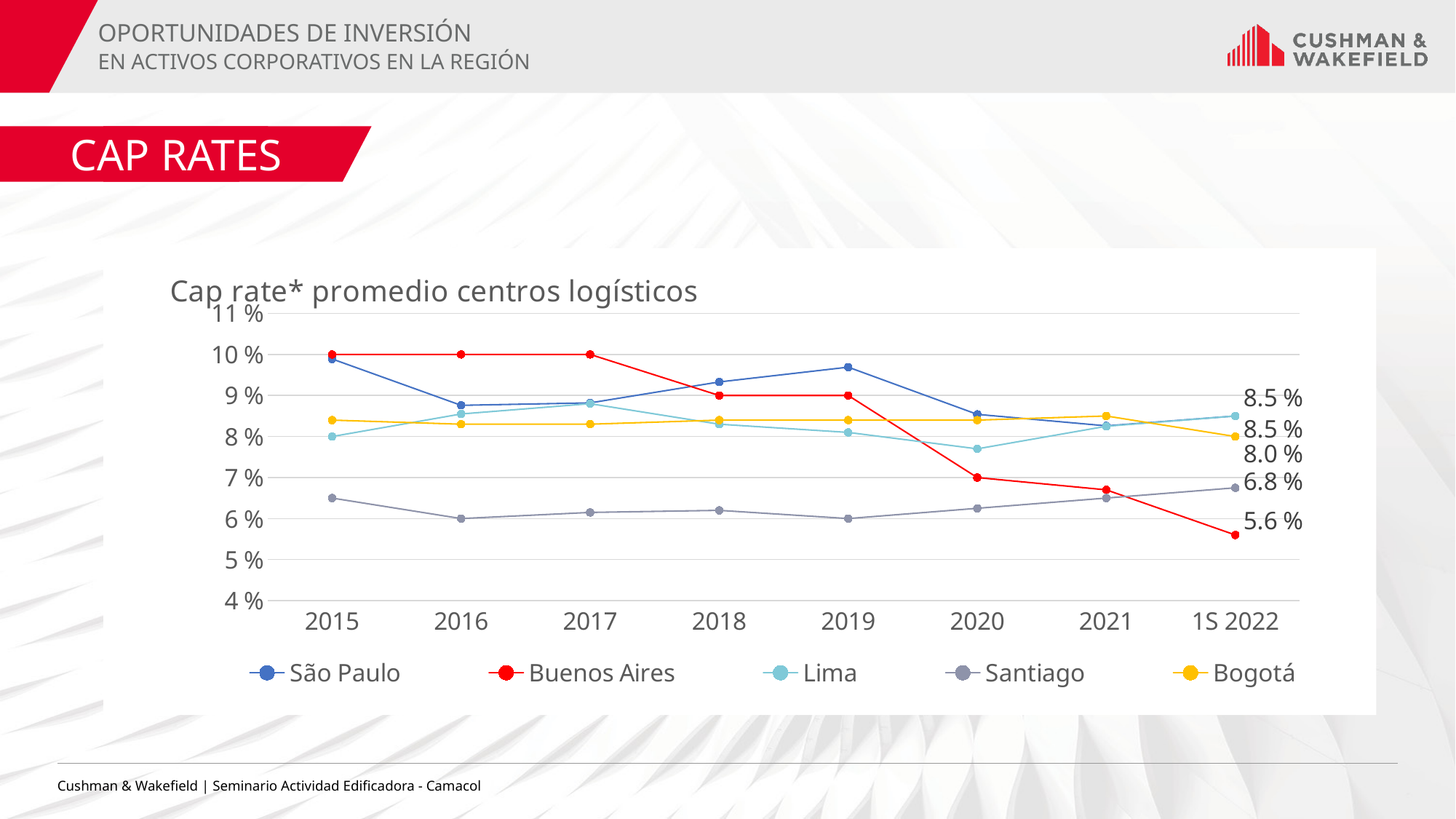
Does the Buenos Aires cap rate rise or fall from 2017 to 1S 2022? Fall How many series does the legend list? 5 What is the cap rate for Buenos Aires in 1S 2022? 5.6 % What is the difference between the Santiago and Buenos Aires cap rates in 1S 2022? 1.2 % What is the cap rate for Buenos Aires in 2016? 10 % What type of chart is shown on the slide? Line chart How many time periods are shown on the x axis? 8 Which city has the lowest cap rate in 2015? Santiago What is the cap rate for Santiago in 1S 2022? 6.8 % Is the cap rate for São Paulo in 2019 greater or less than 9 %? greater What is the cap rate for Bogotá in 1S 2022? 8.0 % Which city has the lowest cap rate in 1S 2022? Buenos Aires